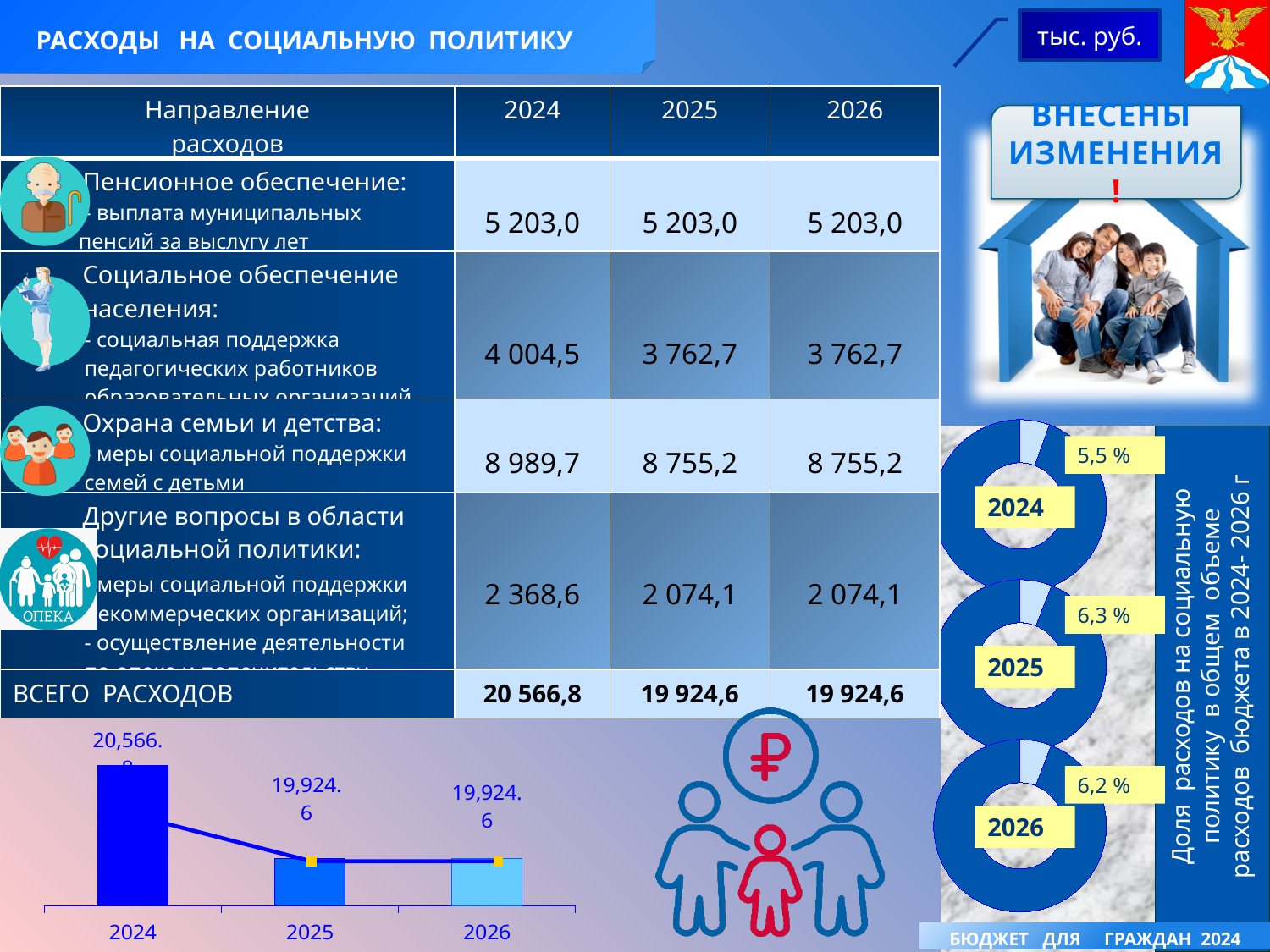
In the bar chart at the bottom left of the slide, how many years are shown on the x axis? 3 In the bar chart at the bottom left of the slide, what is the value for 2024? 20,566.8 What kind of chart is shown at the bottom left of the slide? bar chart In the bar chart at the bottom left of the slide, what is the value for 2026? 19,924.6 In the donut charts on the right of the slide, which year has the highest share? 2025 In the bar chart at the bottom left of the slide, which year has the highest value? 2024 In the bar chart at the bottom left of the slide, do the values rise or fall from 2024 to 2025? fall In the donut charts on the right of the slide, what share is shown for 2024? 5,5 % In the bar chart at the bottom left of the slide, what is the value for 2025? 19,924.6 In the bar chart at the bottom left of the slide, is the value for 2024 larger or smaller than the value for 2025? larger In the bar chart at the bottom left of the slide, what is the difference between the 2024 value and the 2025 value? 642.2 In the donut charts on the right of the slide, what share is shown for 2025? 6,3 %